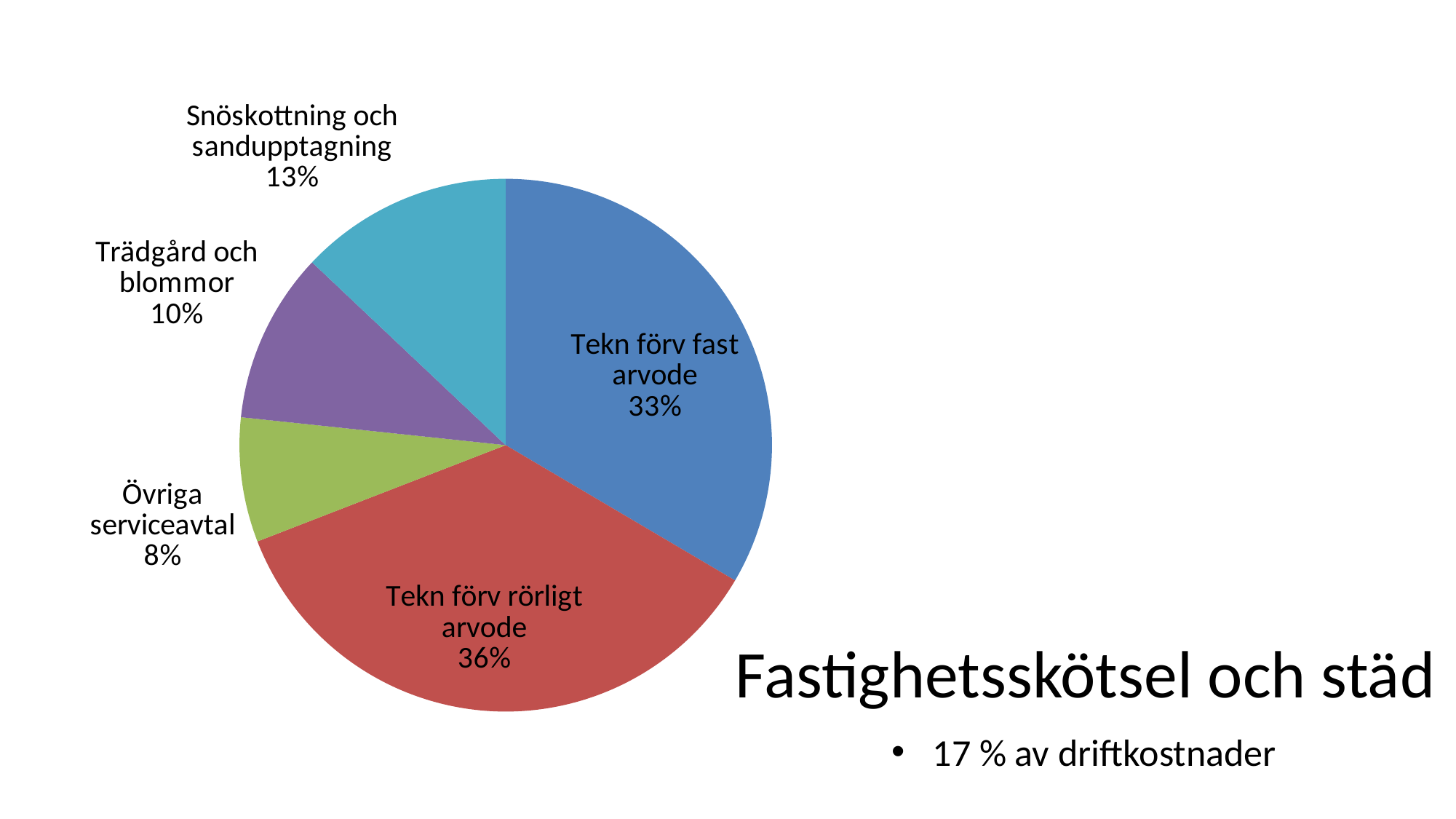
What share of the pie does Tekn förv rörligt arvode have? 36% What share of the pie does Övriga serviceavtal have? 8% What is the difference in percentage points between Tekn förv rörligt arvode and Tekn förv fast arvode? 3 Which category has the largest slice of the pie? Tekn förv rörligt arvode What colour is the slice for Tekn förv fast arvode? blue How many slices does the pie chart have? 5 What share of the pie does Tekn förv fast arvode have? 33% What kind of chart is shown on the slide? pie chart Which is larger, Snöskottning och sandupptagning or Trädgård och blommor? Snöskottning och sandupptagning Which category has the smallest slice of the pie? Övriga serviceavtal